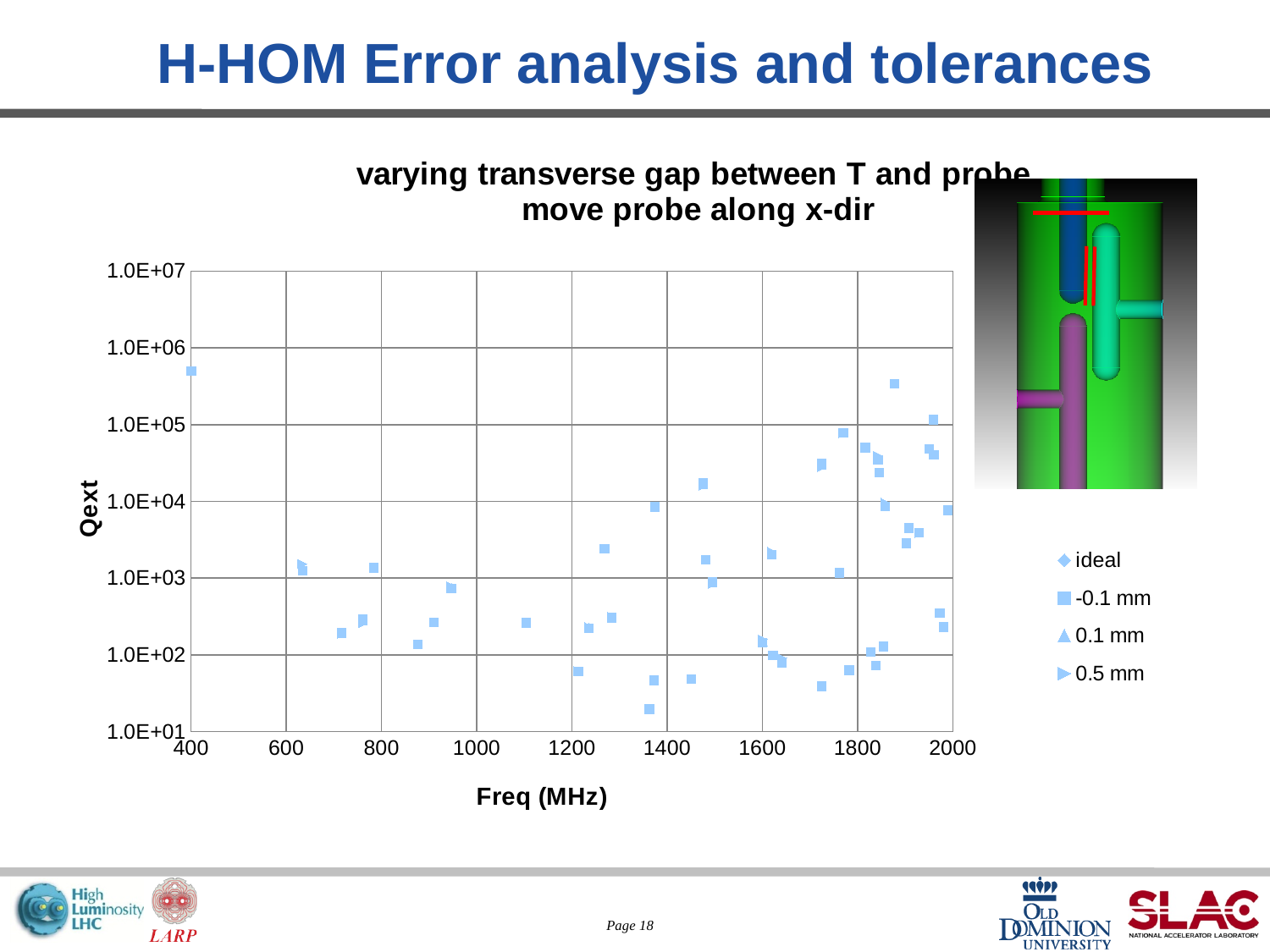
How many series does the chart legend list? 4 Is the highest Qext value plotted on the chart greater or less than 1.0E+06? less Is the Qext value of the point plotted at 400 MHz greater or less than 1.0E+05? greater Is the Qext value of the point plotted near 1360 MHz at the bottom of the chart greater or less than 1.0E+02? less What kind of chart is shown on the slide? Scatter chart What is the title of the chart? varying transverse gap between T and probe move probe along x-dir What label is shown on the x axis of the chart? Freq (MHz)